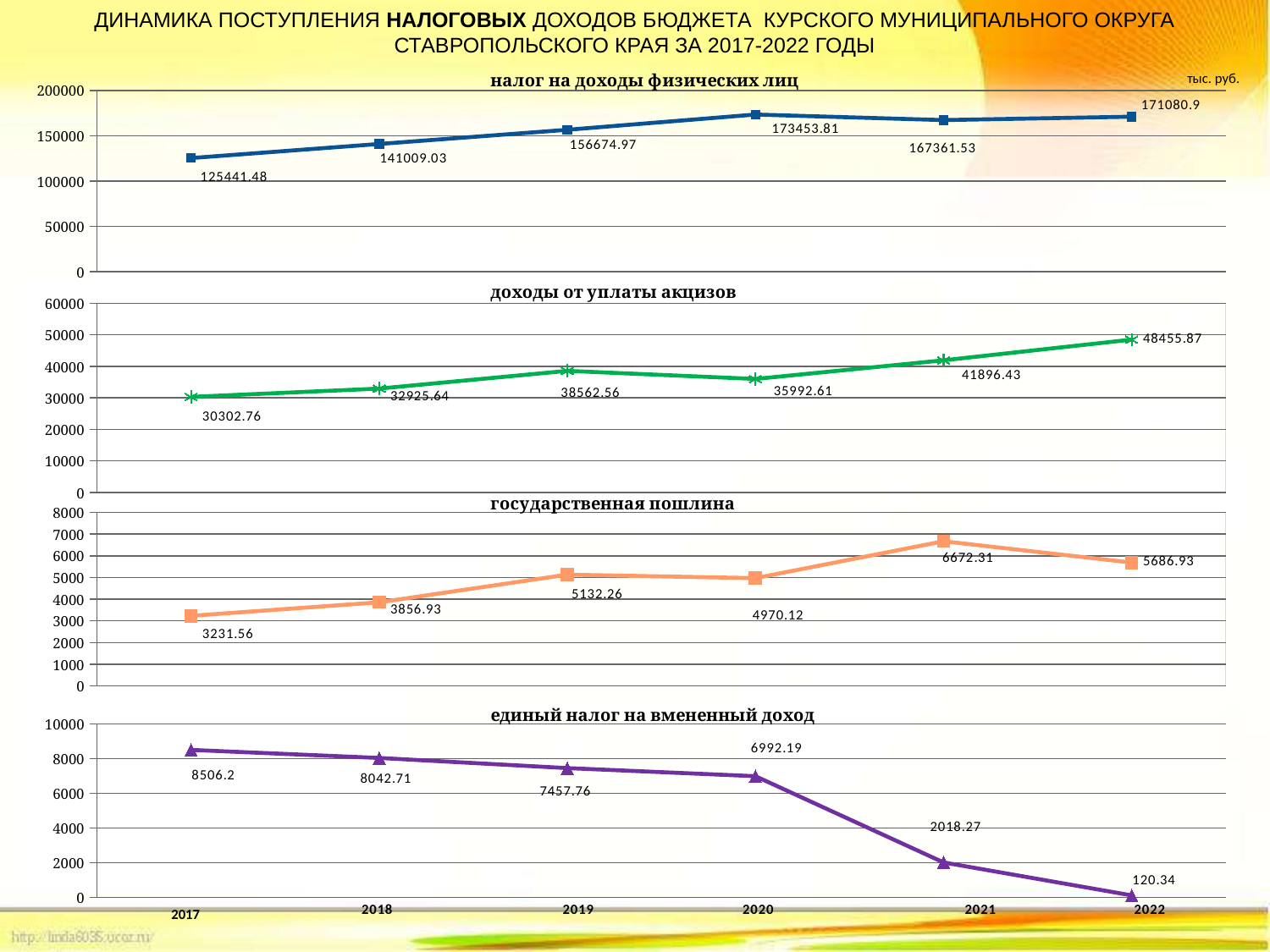
In the chart titled "доходы от уплаты акцизов", what is the difference between the 2022 value and the 2017 value? 18153.11 In the chart titled "государственная пошлина", which is larger, the value for 2019 or the value for 2020? 2019 In the chart titled "доходы от уплаты акцизов", what is the value for 2022? 48455.87 How many data points are plotted in the chart titled "налог на доходы физических лиц"? 6 In the chart titled "единый налог на вмененный доход", what is the value for 2022? 120.34 What kind of chart is the chart titled "государственная пошлина"? line chart In the chart titled "единый налог на вмененный доход", do the values rise or fall from 2017 to 2022? fall In the chart titled "налог на доходы физических лиц", which year has the lowest value? 2017 In the chart titled "налог на доходы физических лиц", what is the value for 2020? 173453.81 In the chart titled "государственная пошлина", what is the value for 2021? 6672.31 In the chart titled "единый налог на вмененный доход", is the value for 2021 greater or less than 4000? less In the chart titled "доходы от уплаты акцизов", which year has the highest value? 2022